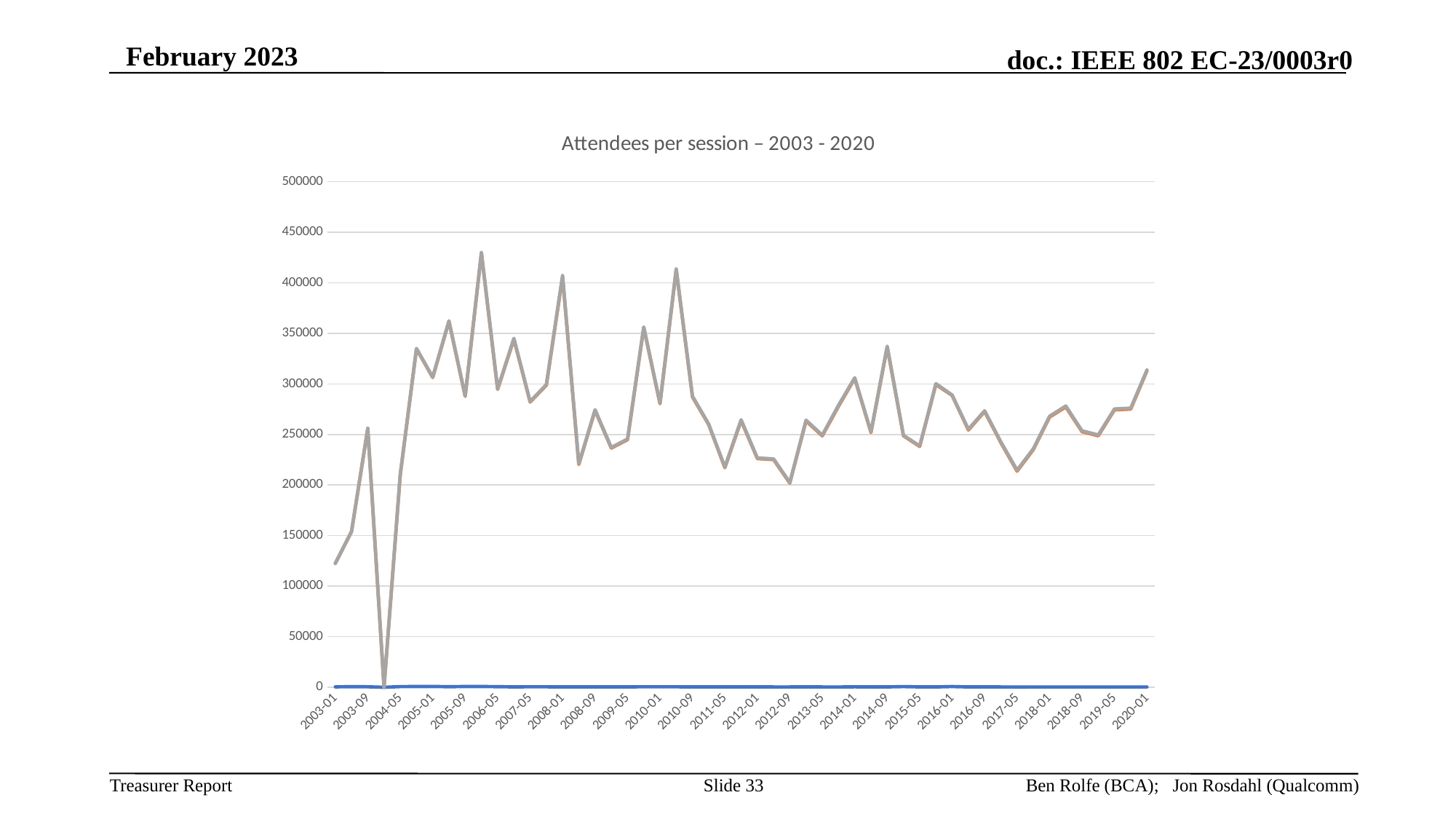
What is the highest value shown on the vertical axis? 500000 Is the value of the gray line at 2014-09 greater or less than 300000? greater Is the value of the gray line at 2020-01 greater or less than 300000? greater What is the title of the chart? Attendees per session – 2003 - 2020 Does the gray line rise or fall between 2003-01 and 2003-09? rise What kind of chart is shown on the slide? line chart Is the value of the gray line at 2017-05 greater or less than 250000? less Which has the larger value on the gray line, 2006-05 or 2003-01? 2006-05